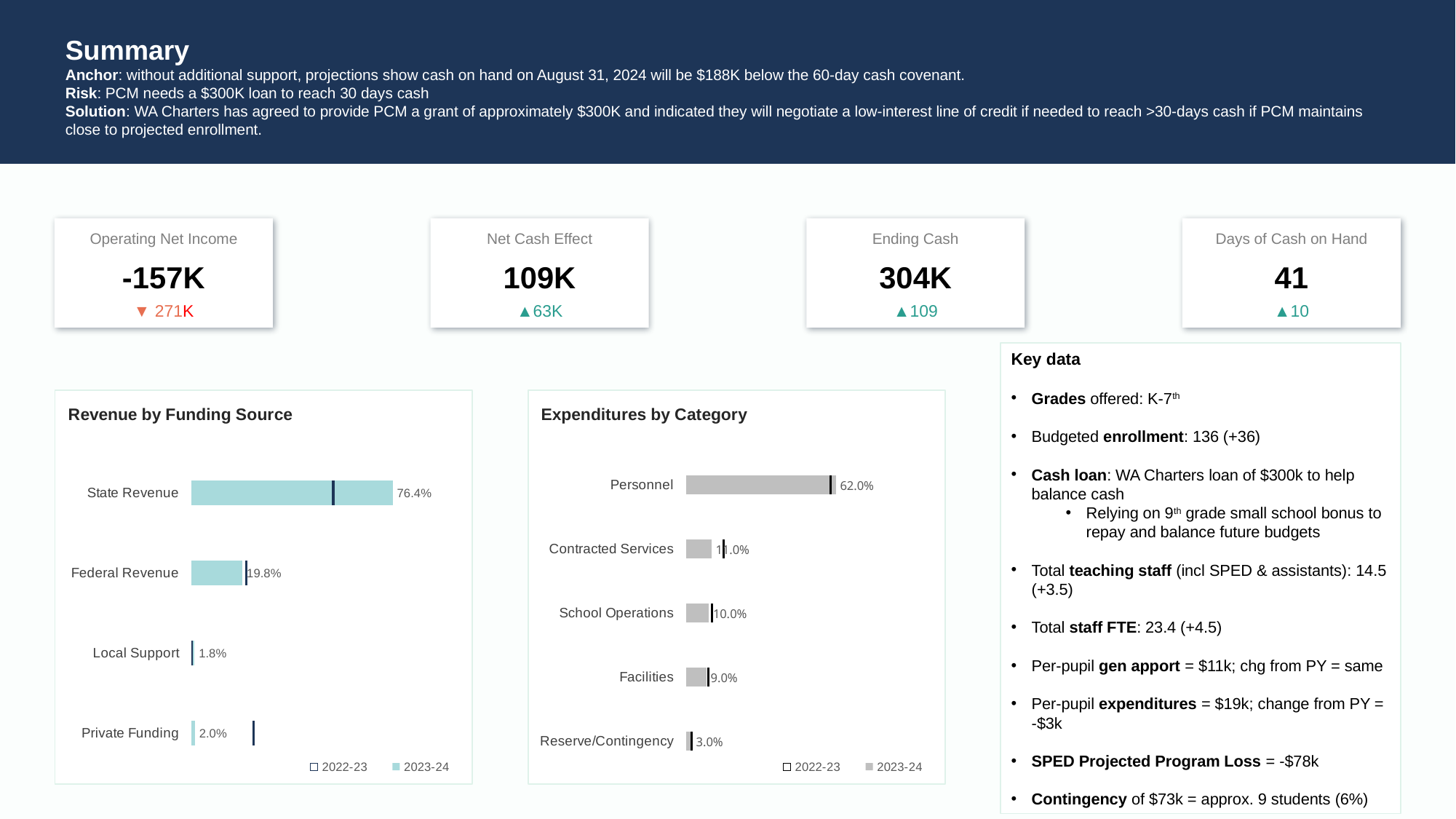
In the Revenue by Funding Source chart, what is the 2023-24 value for State Revenue? 76.4% In the Revenue by Funding Source chart, which funding source has the lowest 2023-24 value? Local Support In the Expenditures by Category chart, what is the 2023-24 value for Personnel? 62.0% In the Revenue by Funding Source chart, what is the 2023-24 value for Federal Revenue? 19.8% In the Expenditures by Category chart, how many expenditure categories are shown? 5 In the Expenditures by Category chart, which category has the highest 2023-24 value? Personnel In the Expenditures by Category chart, which is larger for 2023-24: School Operations or Facilities? School Operations In the Revenue by Funding Source chart, how many funding source categories are shown? 4 In the Revenue by Funding Source chart, what is the difference between the 2023-24 values for State Revenue and Federal Revenue? 56.6% In the Revenue by Funding Source chart, how many series does the legend list? 2 In the Expenditures by Category chart, what is the 2023-24 value for Reserve/Contingency? 3.0% What type of chart is the Expenditures by Category chart? Bar chart